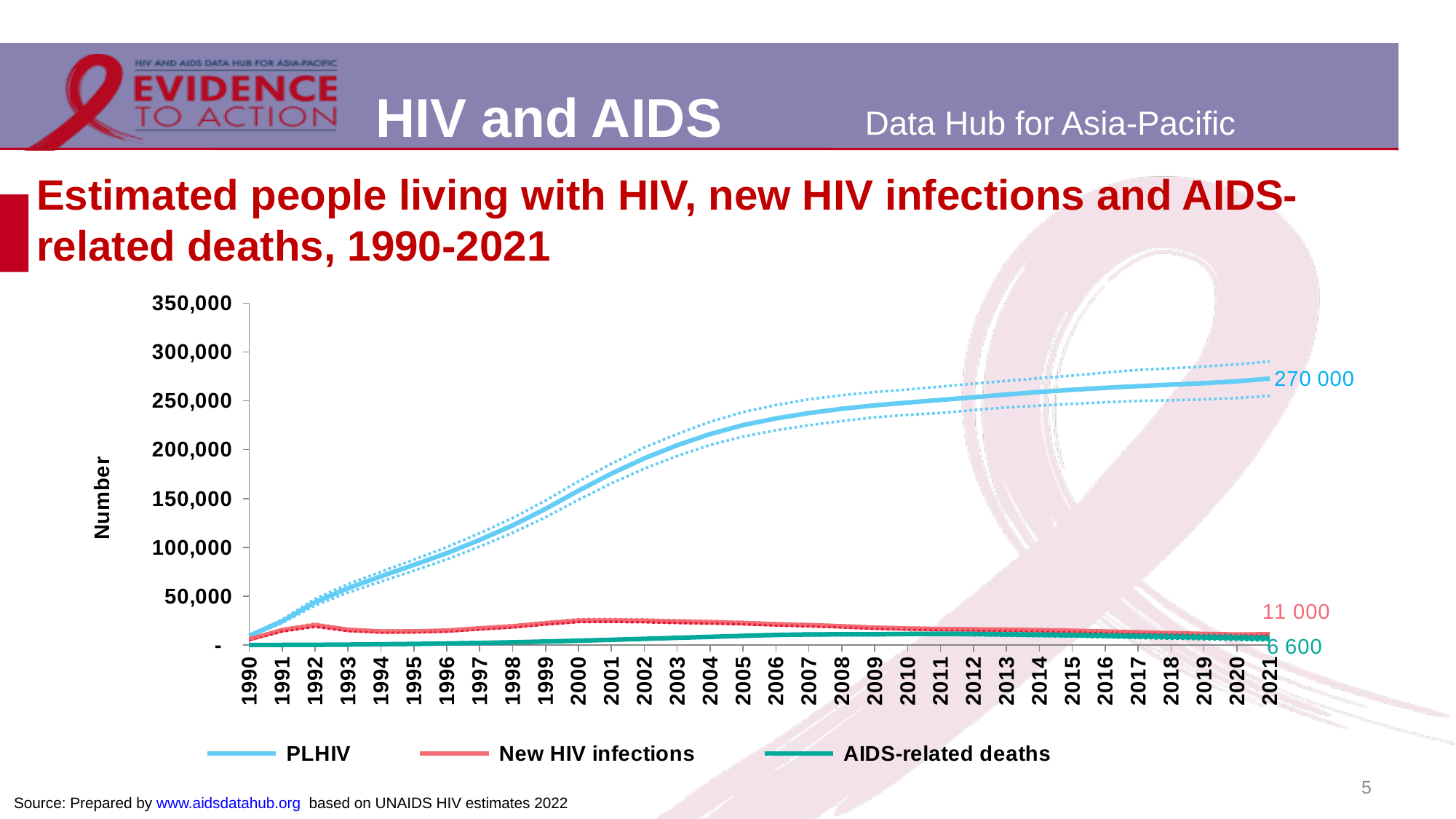
Does the PLHIV line rise or fall from 1990 to 2021? Rises How many series does the legend list? 3 What kind of chart is shown on the slide? Line chart Which series has the lowest value in 2021? AIDS-related deaths Is the value for PLHIV in 1995 greater or less than 100,000? less Which series has the highest value in 2021? PLHIV What is the value of PLHIV in 2021? 270 000 What is the difference between New HIV infections and AIDS-related deaths in 2021? 4 400 Is the value for PLHIV in 2010 greater or less than 200,000? greater What is the value of New HIV infections in 2021? 11 000 What is the value of AIDS-related deaths in 2021? 6 600 In 2021, which is larger: New HIV infections or AIDS-related deaths? New HIV infections